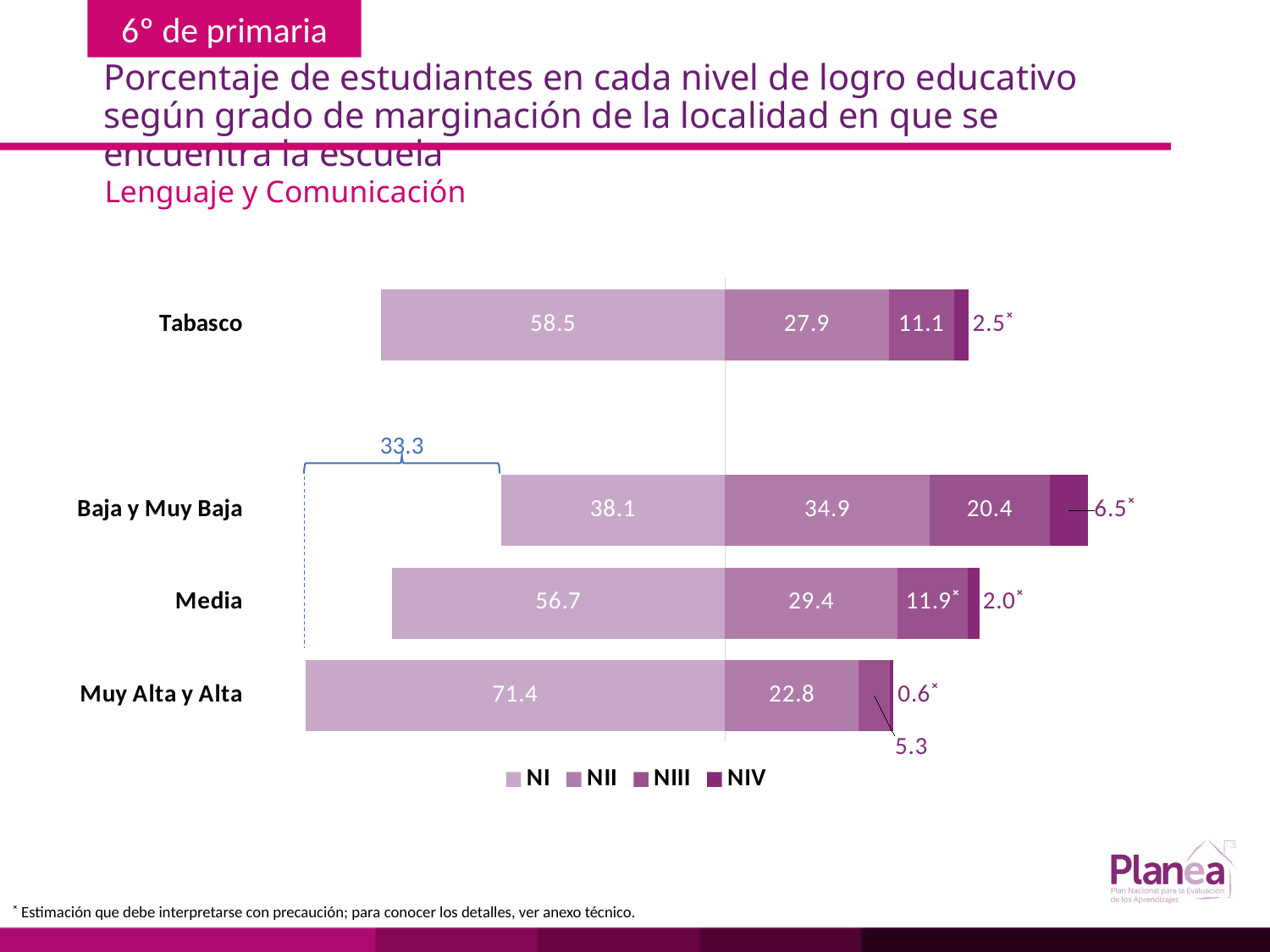
Which is larger, the NII value for Tabasco or the NII value for Media? Media Which category has the lowest NIV value? Muy Alta y Alta What is the NI value for Muy Alta y Alta? 71.4 How many series does the legend list? 4 What is the difference between the NI values of Muy Alta y Alta and Baja y Muy Baja? 33.3 What is the NII value for Baja y Muy Baja? 34.9 How many categories are shown on the chart? 4 What is the NIV value for Baja y Muy Baja? 6.5 What is the NI value for Tabasco? 58.5 What type of chart is shown on the slide? stacked bar chart What is the NIII value for Media? 11.9 Which category has the highest NI value? Muy Alta y Alta